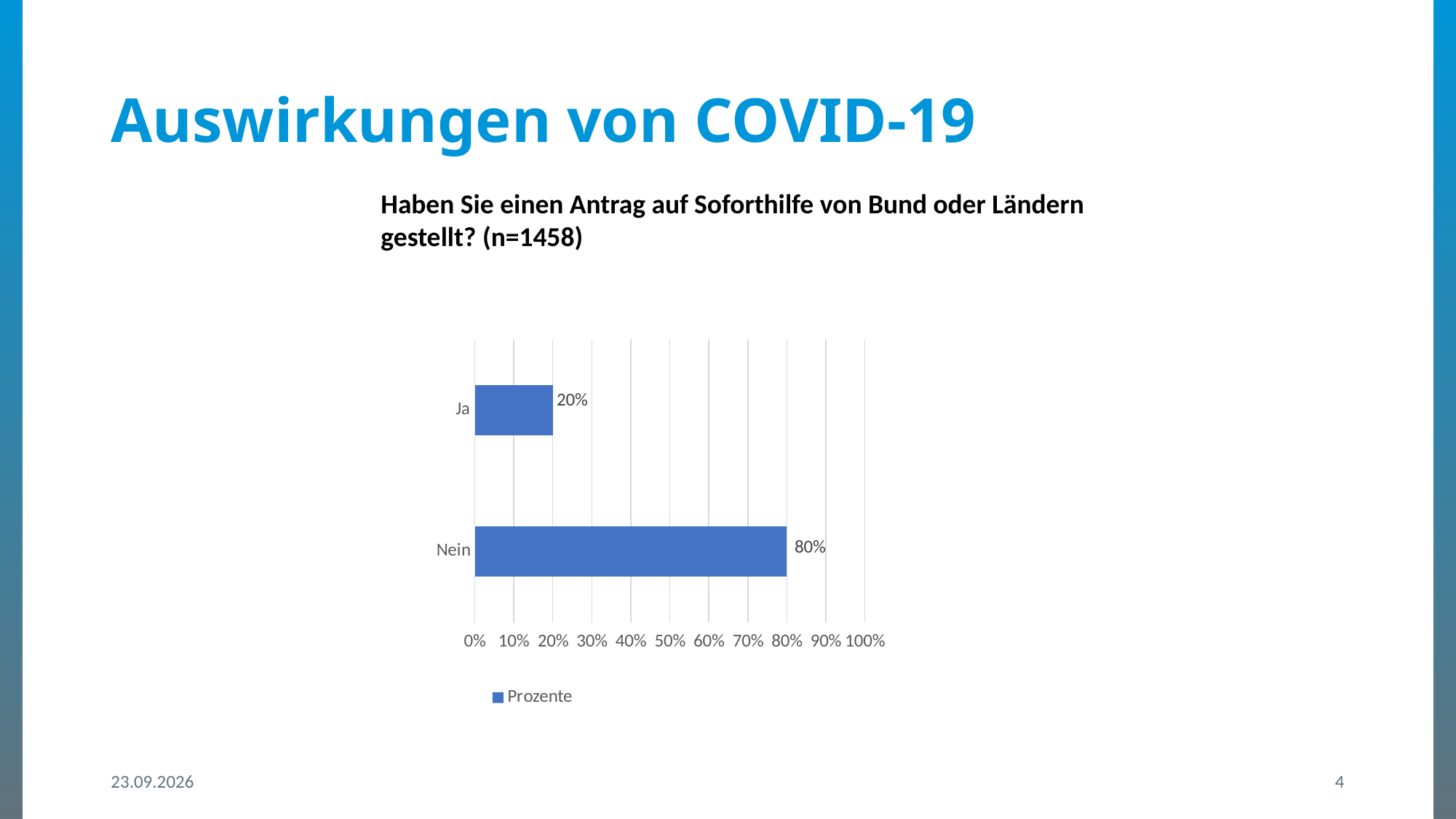
Which category has the lowest value? Ja Which is larger, the value for "Ja" or the value for "Nein"? Nein What is the name of the series listed in the legend? Prozente What is the value for "Nein"? 80% What is the difference between the values for "Nein" and "Ja"? 60% What kind of chart is shown on the slide? bar chart How many categories are shown in the chart? 2 Which category has the highest value? Nein Is the value for "Ja" greater or less than 30%? less How many series does the legend list? 1 What is the value for "Ja"? 20% Is the value for "Nein" greater or less than 50%? greater